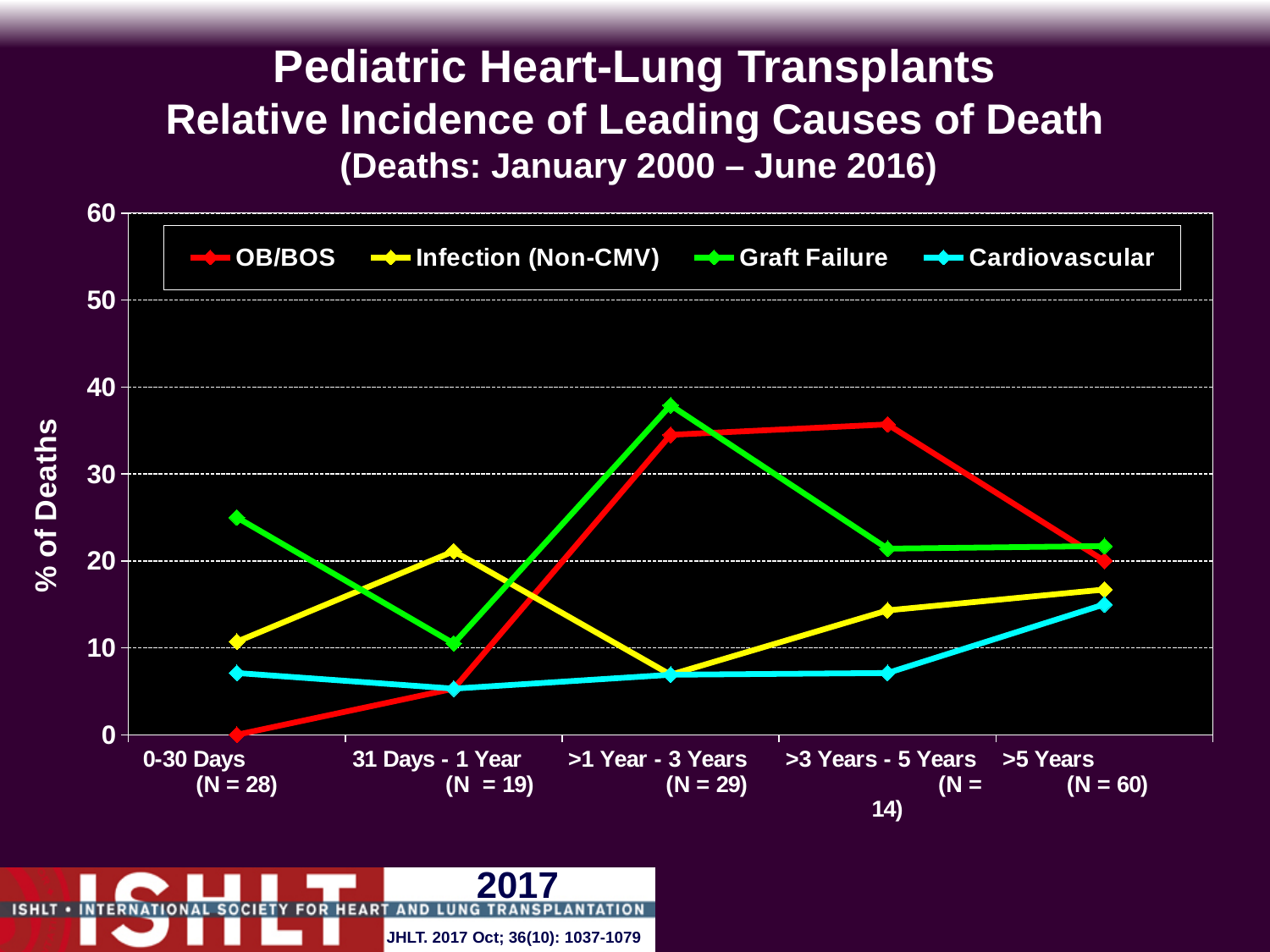
Does the OB/BOS line rise or fall from 0-30 Days to >3 Years - 5 Years? rise Is the value for Graft Failure in the 0-30 Days period greater or less than 20? greater What kind of chart is shown on the slide? line chart Is the value for Cardiovascular in the >5 Years period greater or less than 20? less Which cause of death has the highest value in the >1 Year - 3 Years period? Graft Failure Which cause of death has the lowest value in the 0-30 Days period? OB/BOS Which cause of death has the highest value in the >3 Years - 5 Years period? OB/BOS How many series does the legend list? 4 Which cause of death has the highest value in the 0-30 Days period? Graft Failure How many time-period categories are shown on the x axis? 5 Is the value for Graft Failure in the >1 Year - 3 Years period greater or less than 30? greater In the 31 Days - 1 Year period, which is larger: Infection (Non-CMV) or Graft Failure? Infection (Non-CMV)